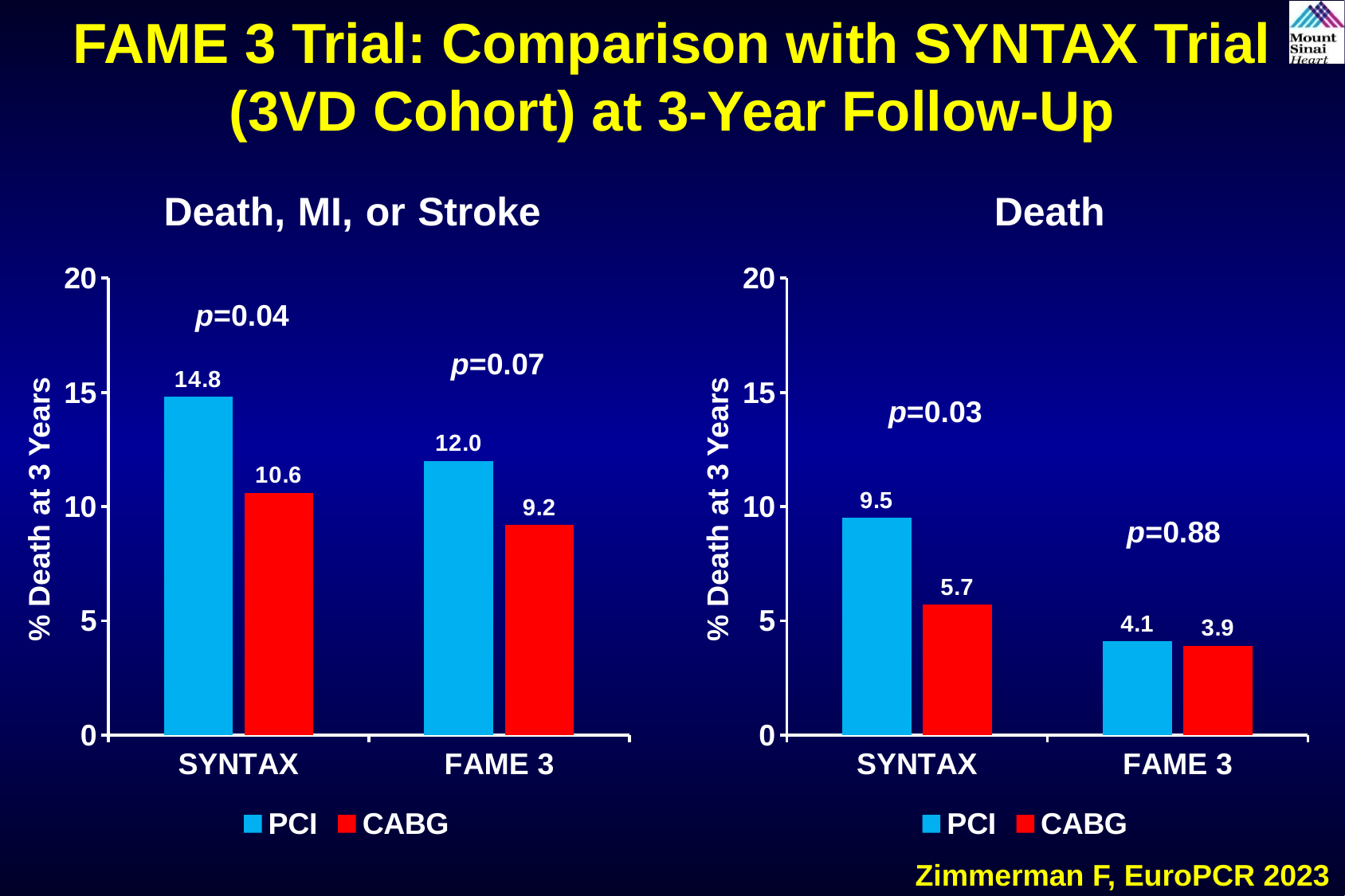
In the 'Death, MI, or Stroke' chart, which bar is the highest? PCI in SYNTAX In the 'Death' chart, what p-value is shown for the FAME 3 comparison? p=0.88 In the 'Death' chart, what is the value for CABG in the SYNTAX trial? 5.7 What kind of chart is the 'Death' chart? Bar chart In the 'Death, MI, or Stroke' chart, what is the value for CABG in FAME 3? 9.2 How many series does the legend of the 'Death' chart list? 2 In the 'Death' chart, what is the difference between PCI and CABG in the SYNTAX trial? 3.8 In the 'Death' chart, which bar is the lowest? CABG in FAME 3 In the 'Death, MI, or Stroke' chart, which is larger for FAME 3: PCI or CABG? PCI In the 'Death, MI, or Stroke' chart, what is the difference between PCI and CABG in the SYNTAX trial? 4.2 In the 'Death, MI, or Stroke' chart, what is the value for PCI in the SYNTAX trial? 14.8 In the 'Death' chart, what is the value for PCI in FAME 3? 4.1